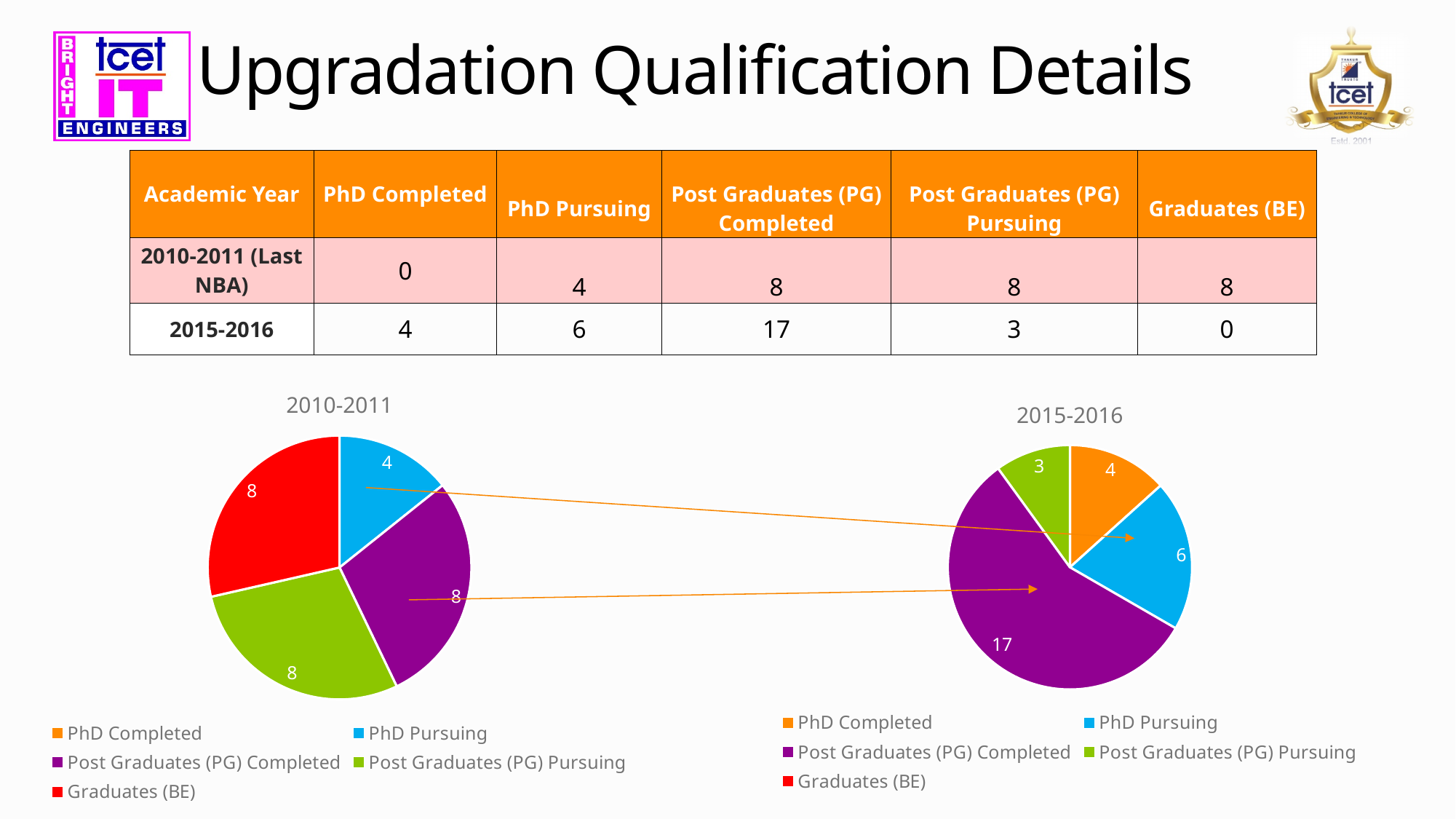
In the 2015-2016 pie chart, what share of the total does Post Graduates (PG) Pursuing represent? 10% In the 2015-2016 pie chart, what colour is the Post Graduates (PG) Completed slice? Purple In the 2010-2011 pie chart, what is the value for Graduates (BE)? 8 How many entries does the legend of the 2010-2011 pie chart list? 5 In the 2015-2016 pie chart, which is larger: PhD Completed or PhD Pursuing? PhD Pursuing In the 2010-2011 pie chart, which category has the smallest visible slice? PhD Pursuing In the 2015-2016 pie chart, what is the difference between Post Graduates (PG) Completed and PhD Pursuing? 11 In the 2010-2011 pie chart, what is the value for PhD Pursuing? 4 In the 2015-2016 pie chart, what is the value for Post Graduates (PG) Completed? 17 In the 2015-2016 pie chart, what is the value for PhD Pursuing? 6 In the 2015-2016 pie chart, which category has the largest slice? Post Graduates (PG) Completed What kind of charts are shown on the slide? Pie charts